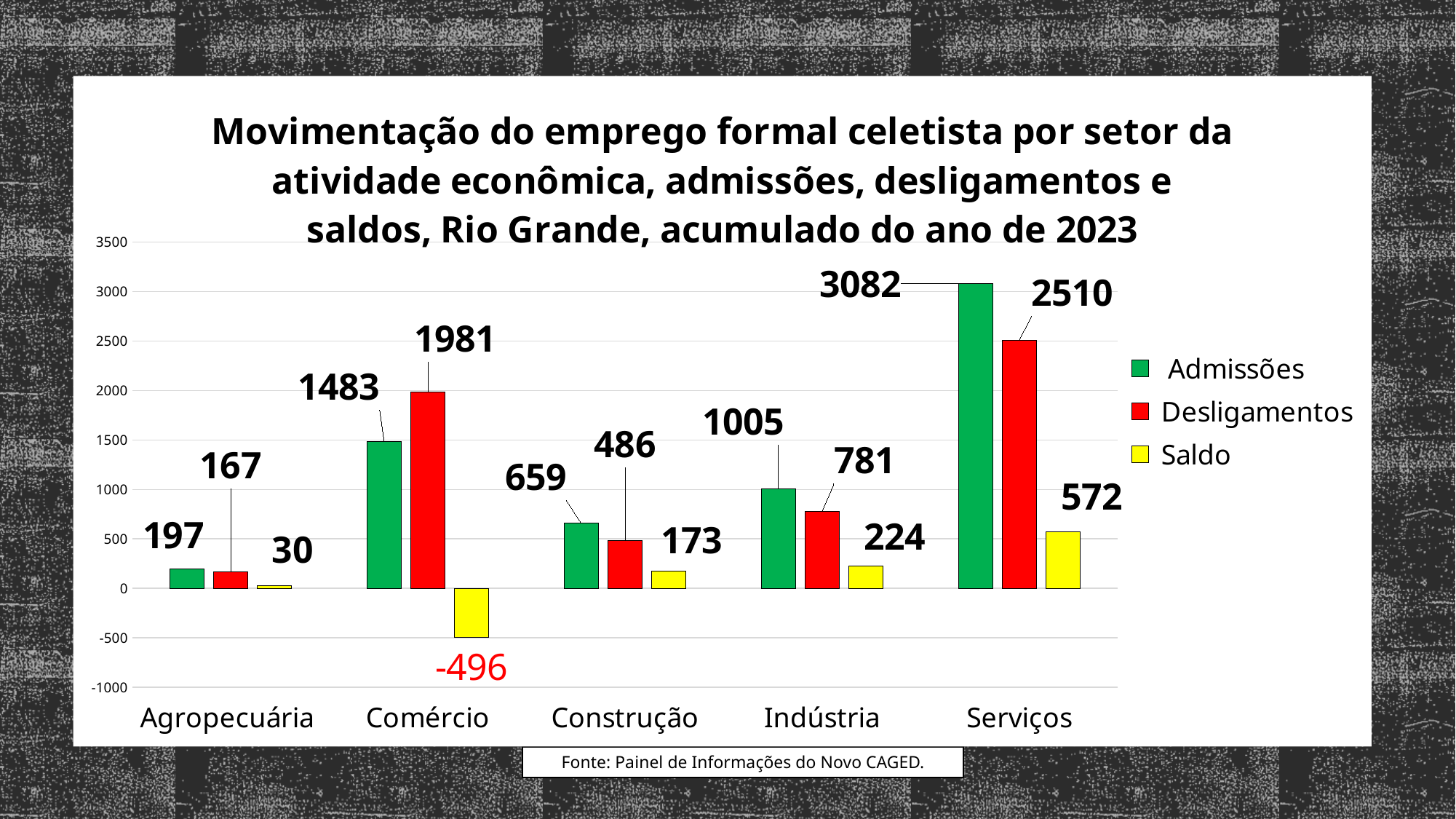
What is the Admissões value for Serviços? 3082 Which is larger for Comércio, Admissões or Desligamentos? Desligamentos What is the Saldo value for Comércio? -496 What is the difference between Admissões and Desligamentos for Construção? 173 What is the Desligamentos value for Comércio? 1981 What is the Saldo value for Indústria? 224 Which sector has the lowest Saldo value? Comércio What kind of chart is shown on the slide? Bar chart What colour represents the Saldo series? Yellow How many sectors are shown on the x axis? 5 How many series does the legend list? 3 Which sector has the highest Admissões value? Serviços